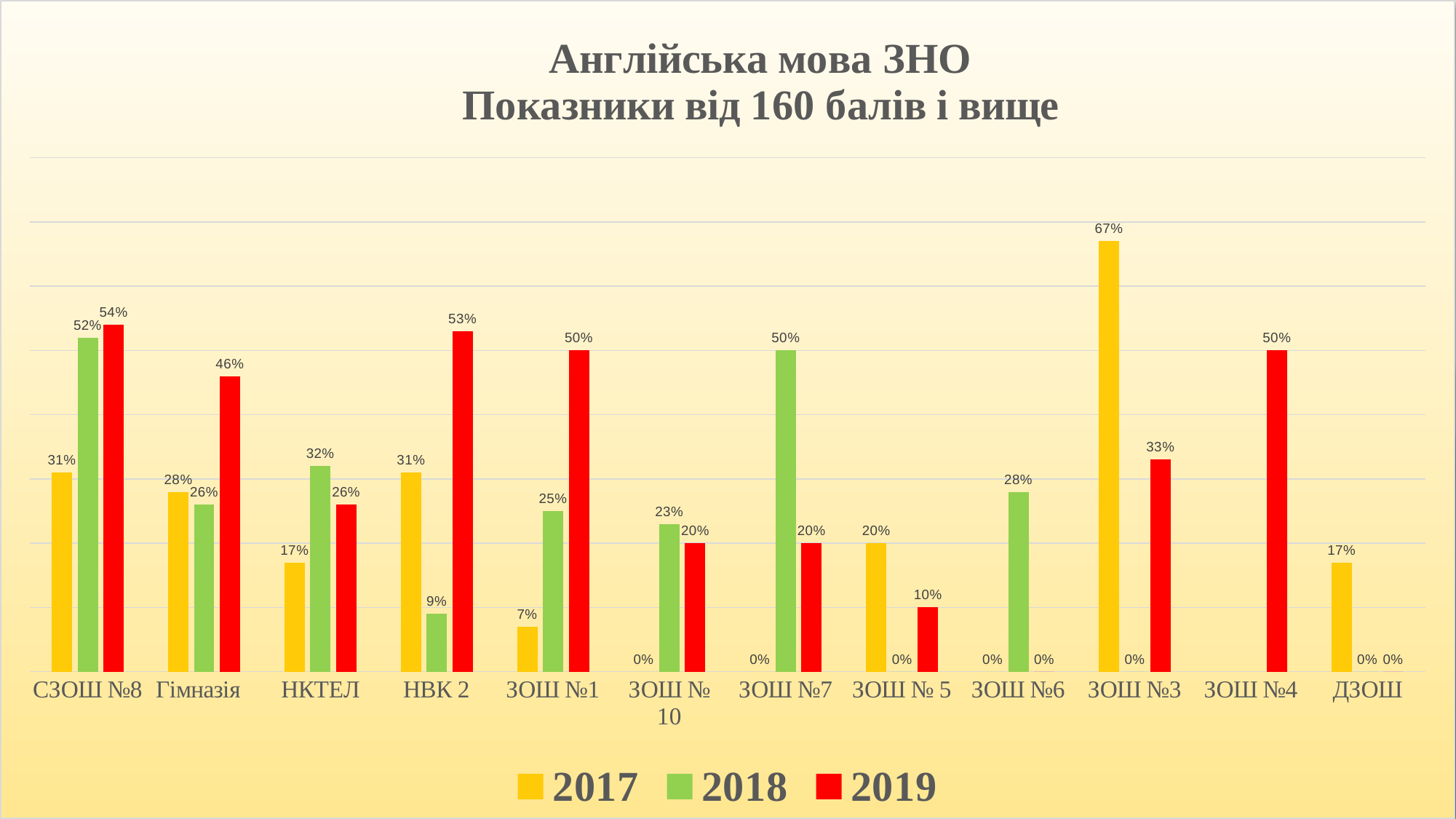
Which school has the highest 2019 value? СЗОШ №8 Which is larger for Гімназія: the 2017 value or the 2018 value? 2017 What is the 2018 value for НКТЕЛ? 32% How many series does the legend list? 3 What is the 2019 value for ЗОШ № 5? 10% What is the 2019 value for СЗОШ №8? 54% What is the difference between the 2019 and 2018 values for НВК 2? 44% Which school has the highest 2017 value? ЗОШ №3 Which series is shown in red in the legend? 2019 What is the 2017 value for ЗОШ №1? 7% What kind of chart is shown on the slide? bar chart How many schools (categories) are shown on the x axis? 12